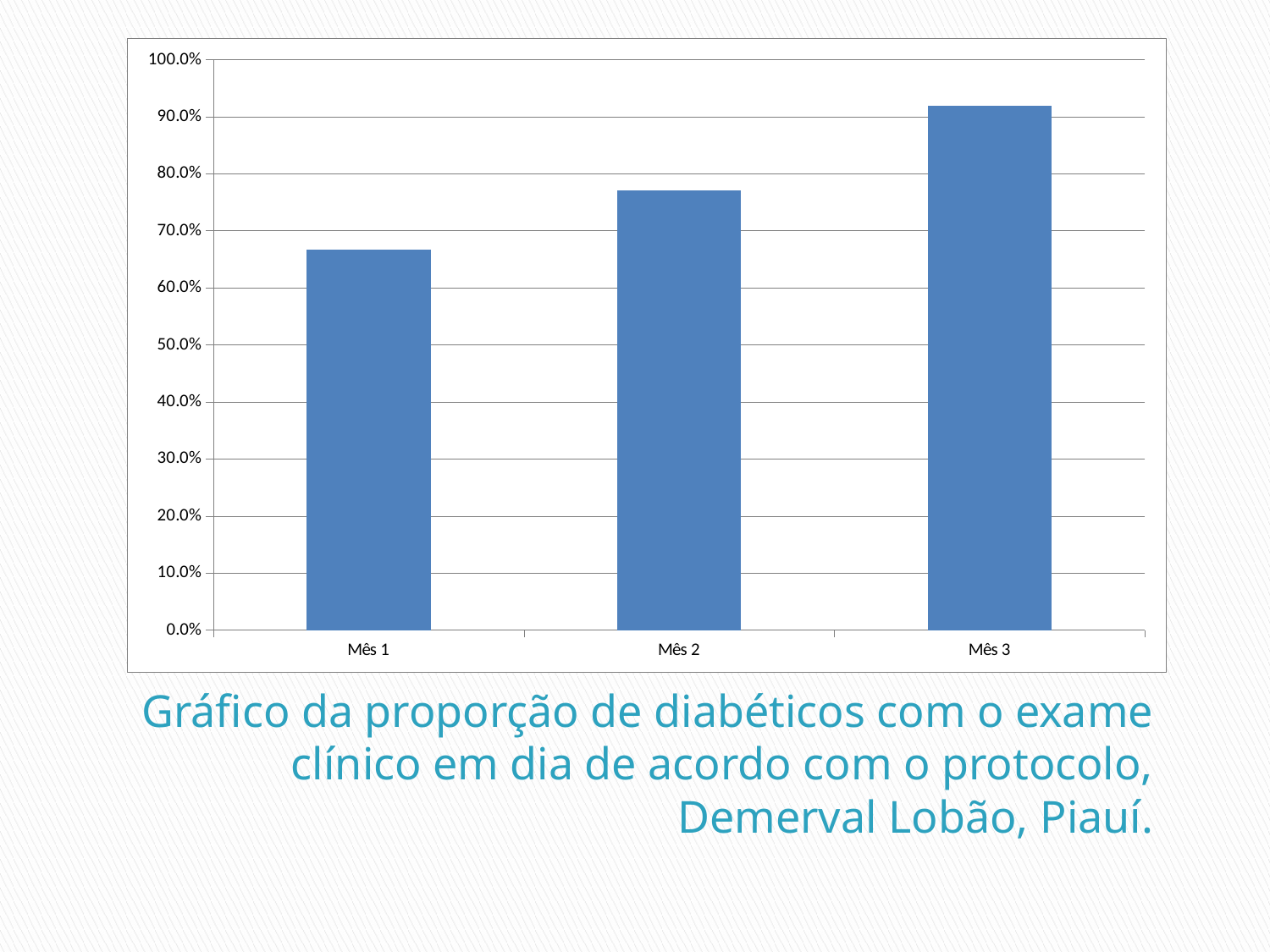
Do the values rise or fall from Mês 1 to Mês 3? rise What is the maximum value shown on the y axis? 100.0% Is the value for Mês 1 greater or less than 60.0%? greater Which is larger, the value for Mês 2 or the value for Mês 3? Mês 3 Is the value for Mês 2 greater or less than 80.0%? less How many categories are plotted on the x axis? 3 Is the value for Mês 2 greater or less than 70.0%? greater What kind of chart is shown on the slide? bar chart Which month has the lowest bar? Mês 1 Which month has the highest bar? Mês 3